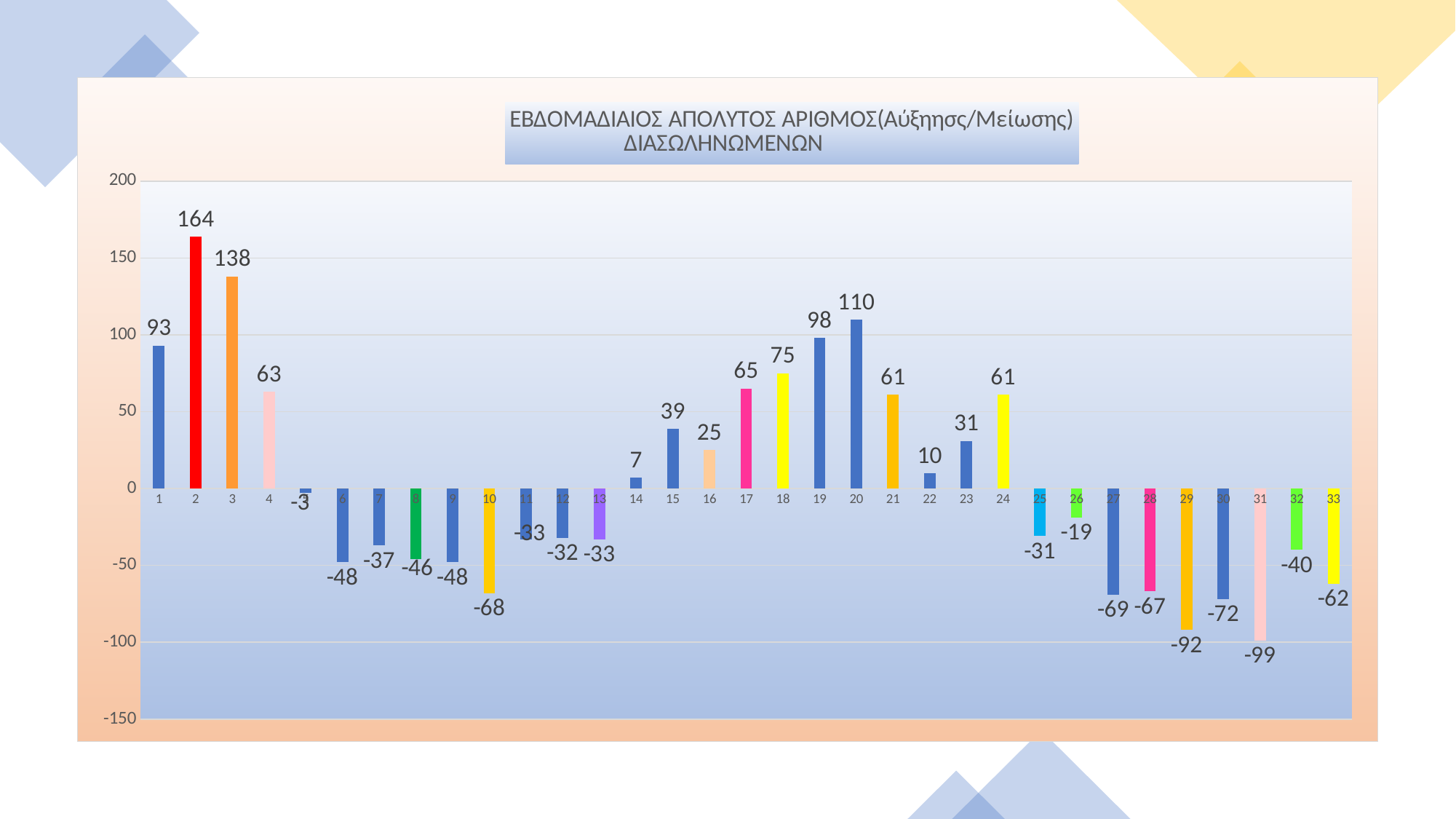
Which week has the highest value? 2 What is the value for week 29? -92 What is the value for week 2? 164 What is the value for week 31? -99 What type of chart is shown on the slide? bar chart What is the title of the chart? ΕΒΔΟΜΑΔΙΑΙΟΣ ΑΠΟΛΥΤΟΣ ΑΡΙΘΜΟΣ(Αύξηησς/Μείωσης) ΔΙΑΣΩΛΗΝΩΜΕΝΩΝ Which is larger, the value for week 19 or the value for week 20? week 20 How many weeks (categories) are plotted on the chart? 33 What is the value for week 20? 110 What is the difference between the values for week 18 and week 17? 10 Which week has the lowest value? 31 What is the difference between the values for week 2 and week 3? 26